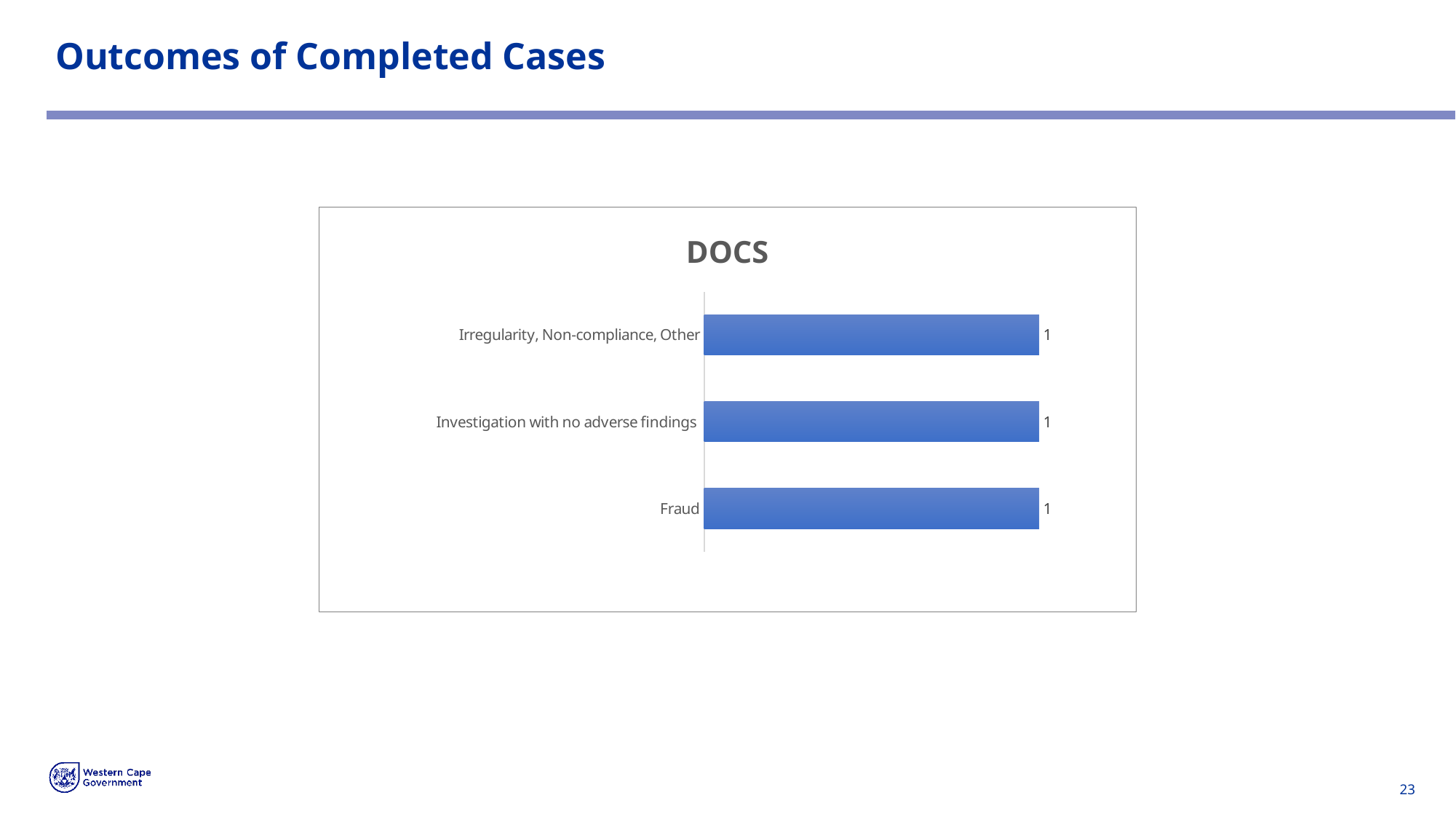
What is the difference between the values for Fraud and Investigation with no adverse findings in the DOCS chart? 0 What is the value for Investigation with no adverse findings in the DOCS chart? 1 What kind of chart is the DOCS chart? Bar chart What is the total of all the values shown in the DOCS chart? 3 Are the bars in the DOCS chart horizontal or vertical? Horizontal What is the value for Irregularity, Non-compliance, Other in the DOCS chart? 1 Do all categories in the DOCS chart have the same value? Yes What is the title of the chart on the slide? DOCS What is the value for Fraud in the DOCS chart? 1 How many categories are shown in the DOCS chart? 3